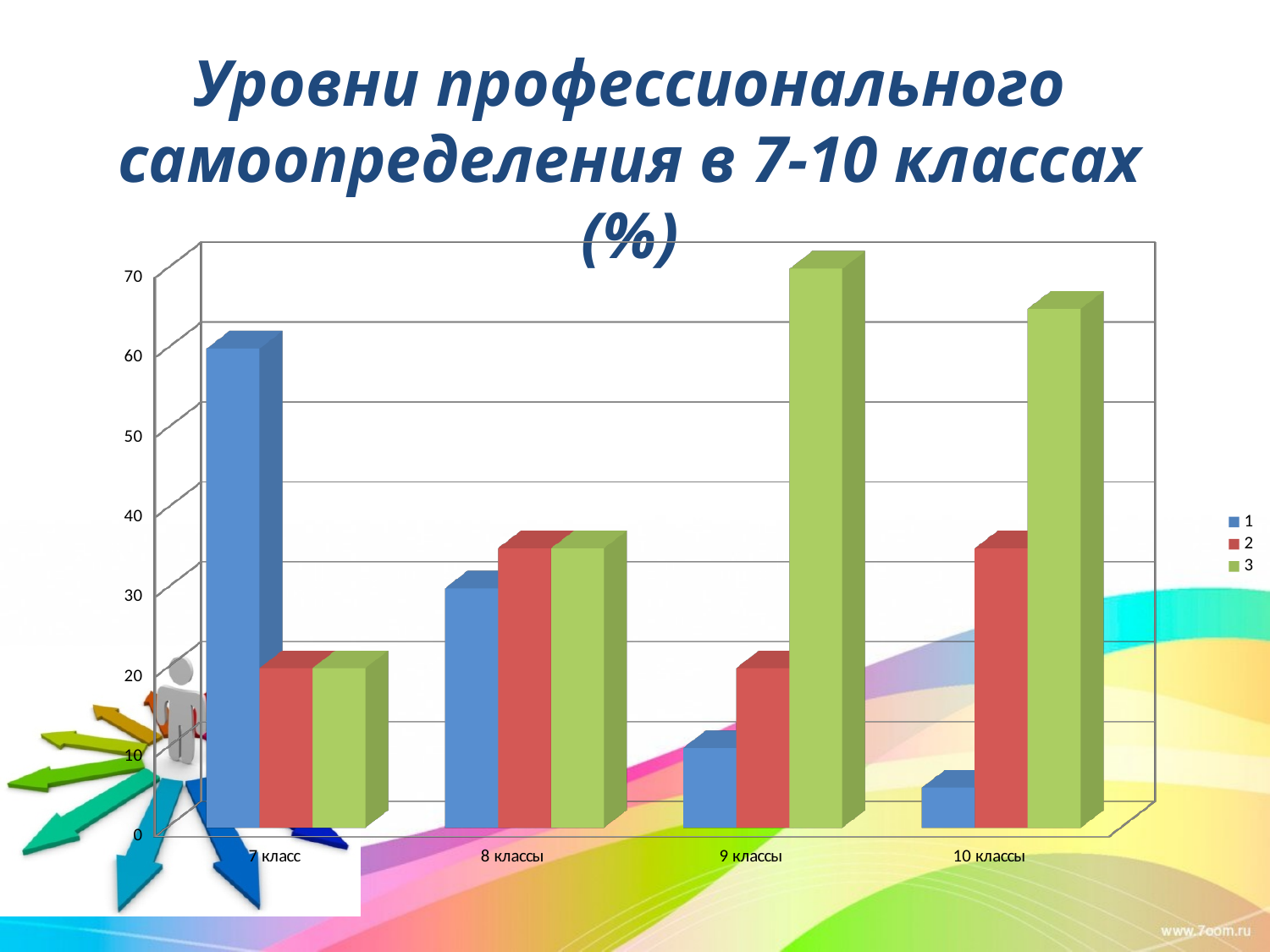
What colour are the bars for series 3 in the chart? green Is the value of series 1 for 7 класс greater or less than 50? greater Which is larger for 8 классы: series 1 or series 2? series 2 Which series has the highest value for 9 классы? 3 Which series has the highest value for 7 класс? 1 Which series has the lowest value for 10 классы? 1 How many series does the legend list? 3 What kind of chart is shown on the slide? bar chart How many categories are shown on the x axis of the chart? 4 Is the value of series 1 for 10 классы greater or less than 10? less Is the value of series 3 for 9 классы greater or less than 60? greater Does the value of series 1 rise or fall from 7 класс to 10 классы? fall